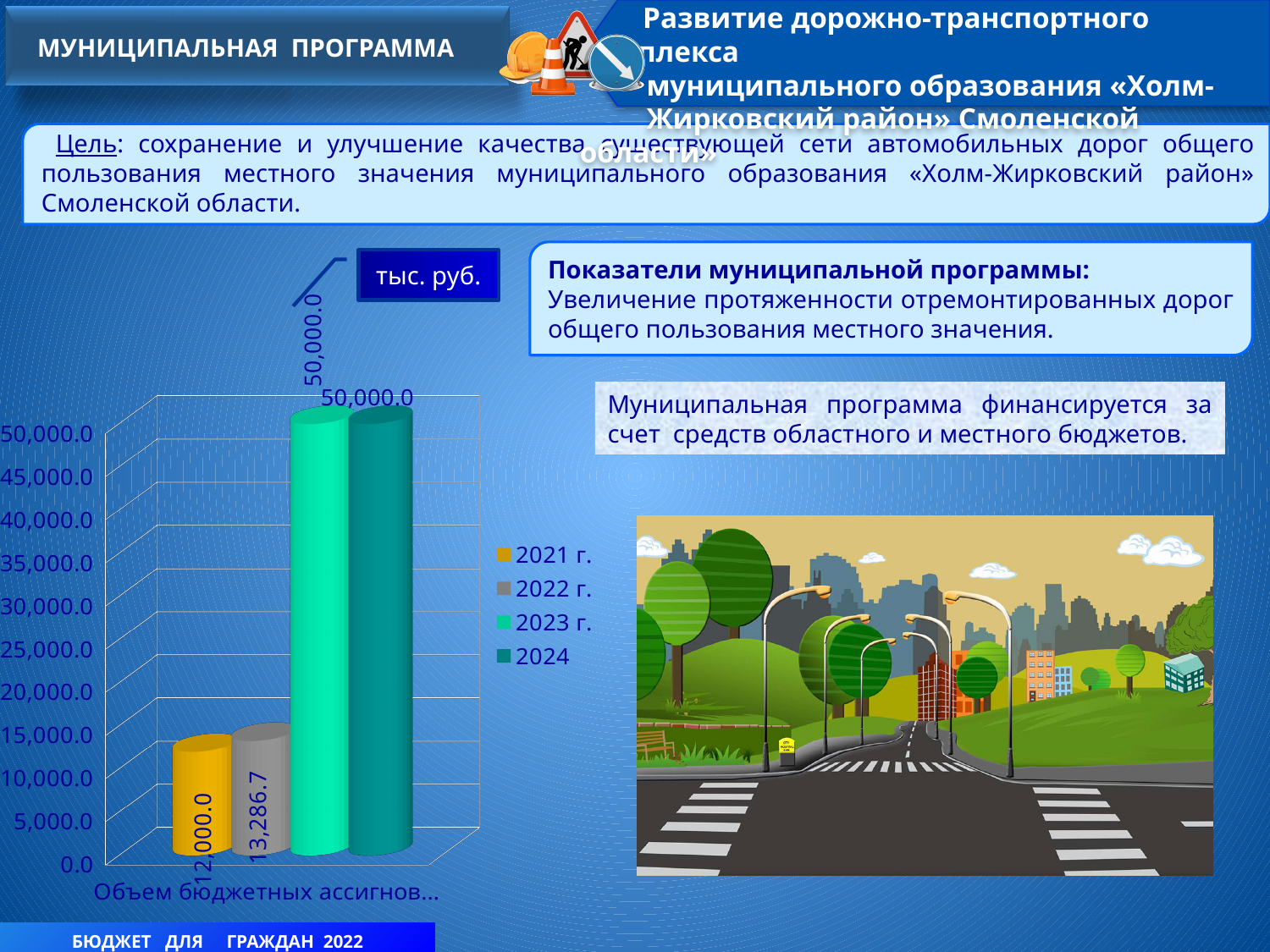
Which is larger, the value for 2022 г. or the value for 2021 г.? 2022 г. How many series does the legend list? 4 What is the value for 2024 in the chart? 50,000.0 Is the value for 2022 г. greater or less than 15,000.0? less What is the value for 2023 г. in the chart? 50,000.0 Which series has the lowest value in the chart? 2021 г. What is the difference between the values for 2022 г. and 2021 г.? 1,286.7 What kind of chart is shown on the slide? bar chart What is the difference between the values for 2023 г. and 2022 г.? 36,713.3 What is the value for 2022 г. in the chart? 13,286.7 What is the value for 2021 г. in the chart? 12,000.0 What unit is indicated in the box above the chart? тыс. руб.